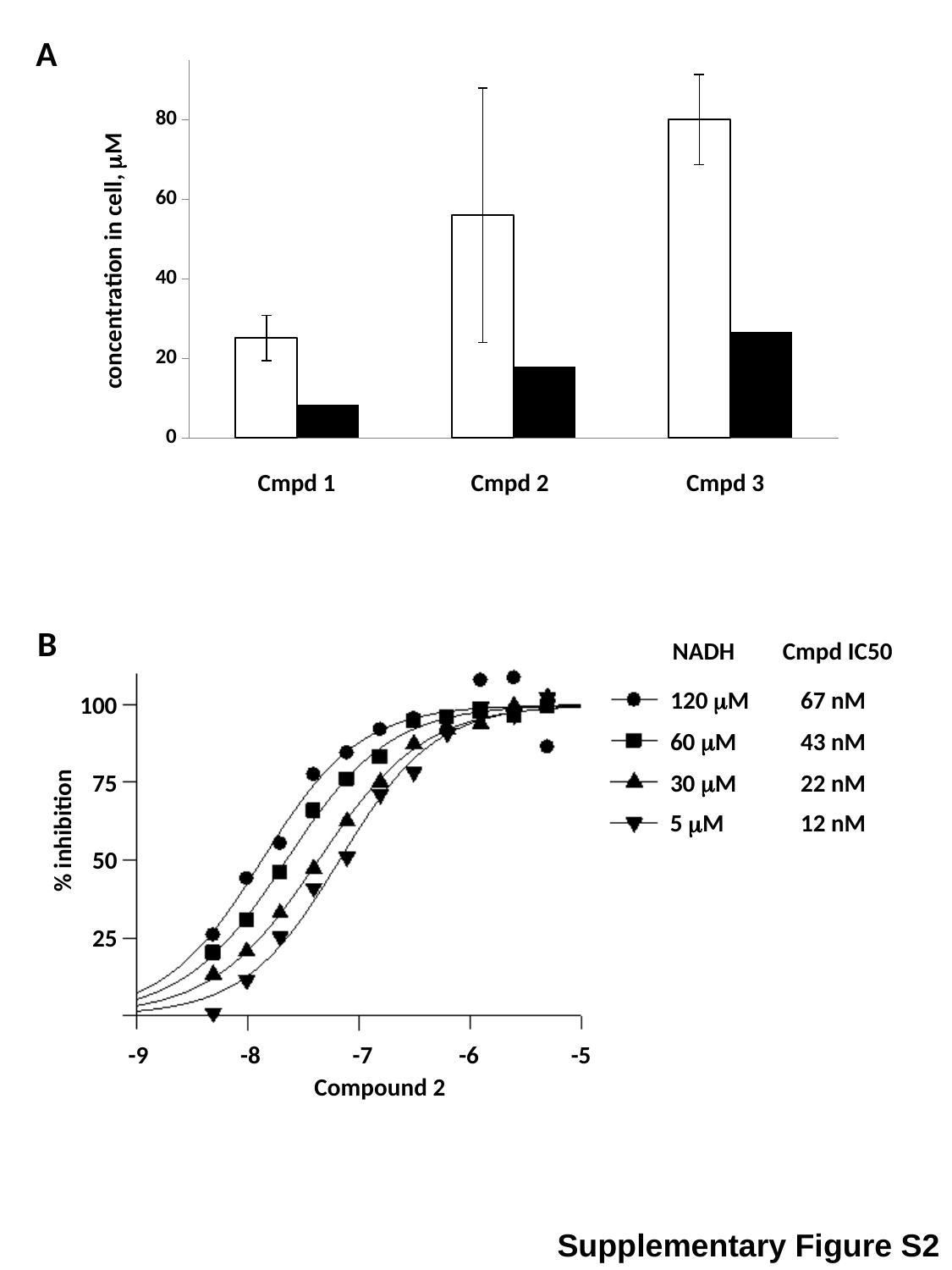
In chart B, does % inhibition rise or fall as the x-axis value increases from -9 to -5? rise In chart A, is the white bar for Cmpd 2 greater or less than 40? greater In chart A, how many compounds are shown on the x axis? 3 What kind of chart is chart A at the top of the slide? bar chart In chart A, which compound has the shortest black bar? Cmpd 1 In chart B, what is the Cmpd IC50 at 60 µM NADH? 43 nM In chart A, is the black bar for Cmpd 1 greater or less than 20? less In chart B, which NADH concentration gives the lowest Cmpd IC50? 5 µM In chart A, which is larger for Cmpd 3: the white bar or the black bar? the white bar In chart B, what is the difference between the Cmpd IC50 at 120 µM NADH and at 60 µM NADH? 24 nM In chart A, which compound has the tallest white bar? Cmpd 3 In chart B, how many NADH concentrations does the legend list? 4